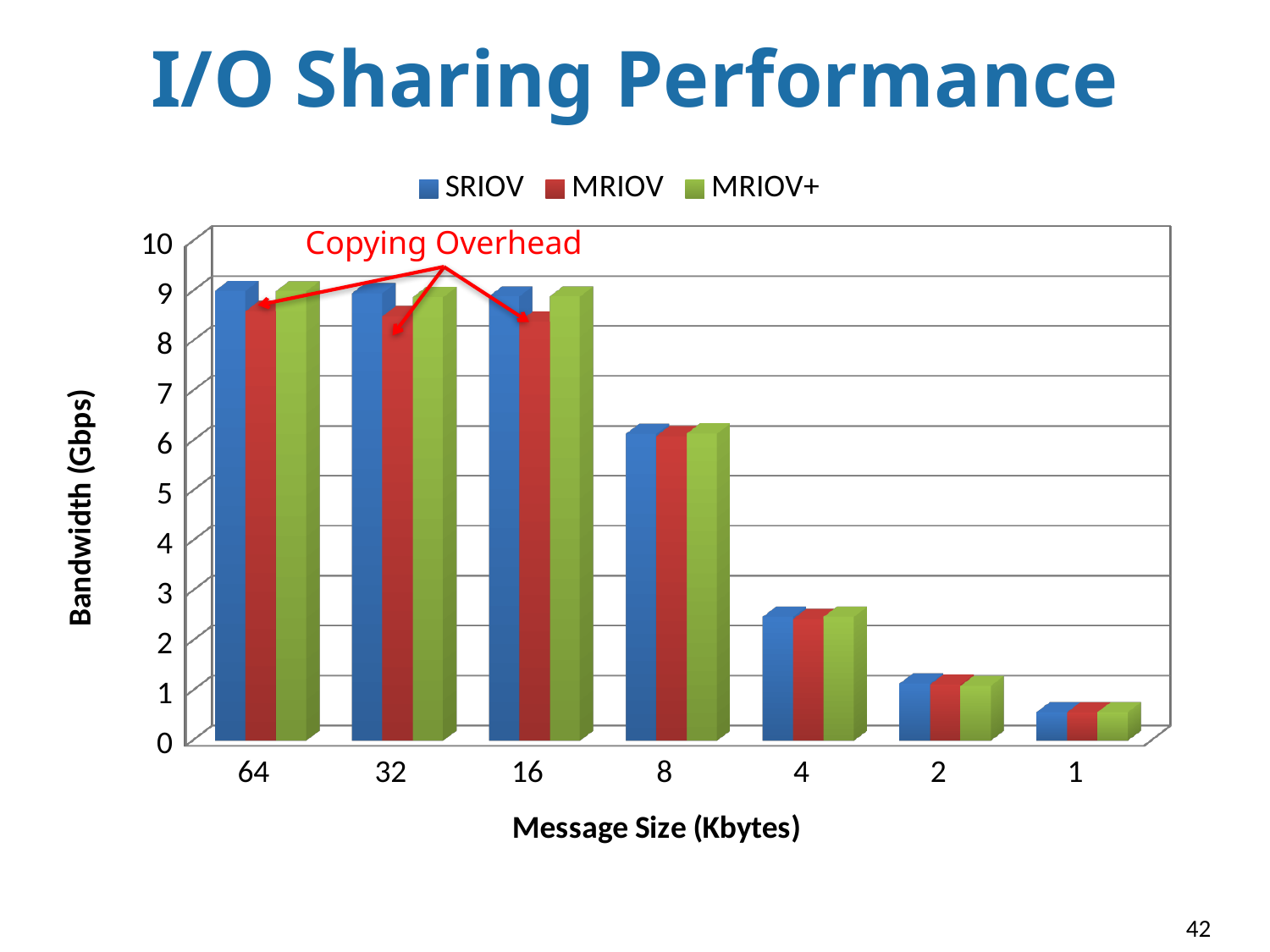
Which series do the 'Copying Overhead' arrows point to? MRIOV Is the MRIOV+ bandwidth at message size 1 greater or less than 1? less At message size 64, which has the higher bandwidth, SRIOV or MRIOV? SRIOV Do the bandwidth values rise or fall moving from left to right along the x axis? fall Is the SRIOV bandwidth at message size 64 greater or less than 8? greater How many series does the legend list? 3 What kind of chart is shown on the slide? bar chart At message size 32, which has the higher bandwidth, MRIOV or MRIOV+? MRIOV+ How many message sizes are shown on the x axis? 7 Which message size has the lowest bandwidth for SRIOV? 1 Is the MRIOV bandwidth at message size 8 greater or less than 5? greater